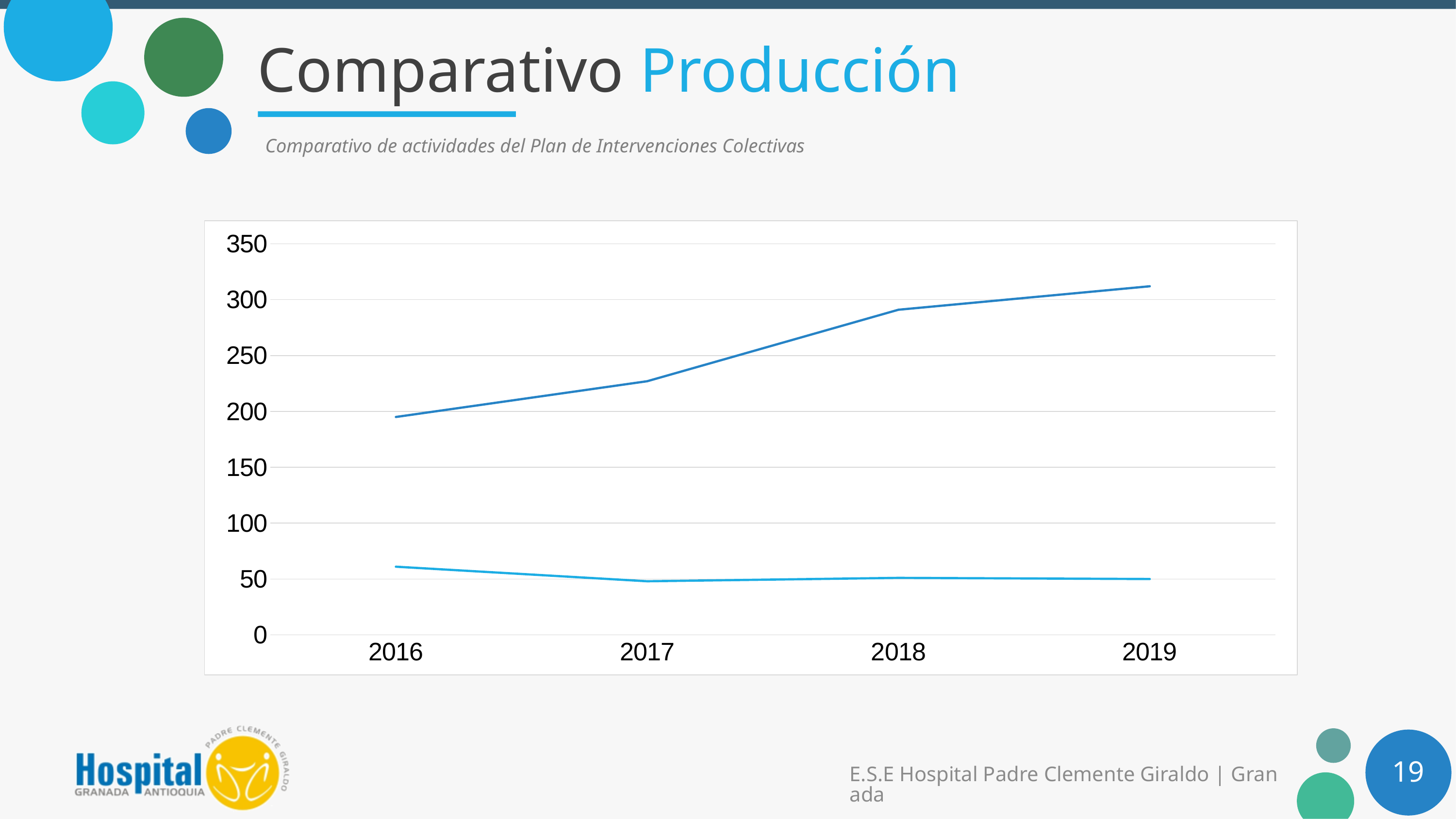
Is the value of the lower line in 2016 greater or less than 50? greater In which year does the upper line reach its highest value? 2019 In which year does the lower line have its highest value? 2016 What is the subtitle text shown below the slide title? Comparativo de actividades del Plan de Intervenciones Colectivas In which year does the upper line have its lowest value? 2016 Does the upper line rise or fall from 2016 to 2019? rise How many years are shown on the x axis of the chart? 4 Which is larger for the upper line, the value in 2018 or the value in 2019? 2019 How many lines are plotted in the chart? 2 Is the value of the upper line in 2019 greater or less than 300? greater Is the value of the upper line in 2017 greater or less than 200? greater What kind of chart is shown on the slide? line chart